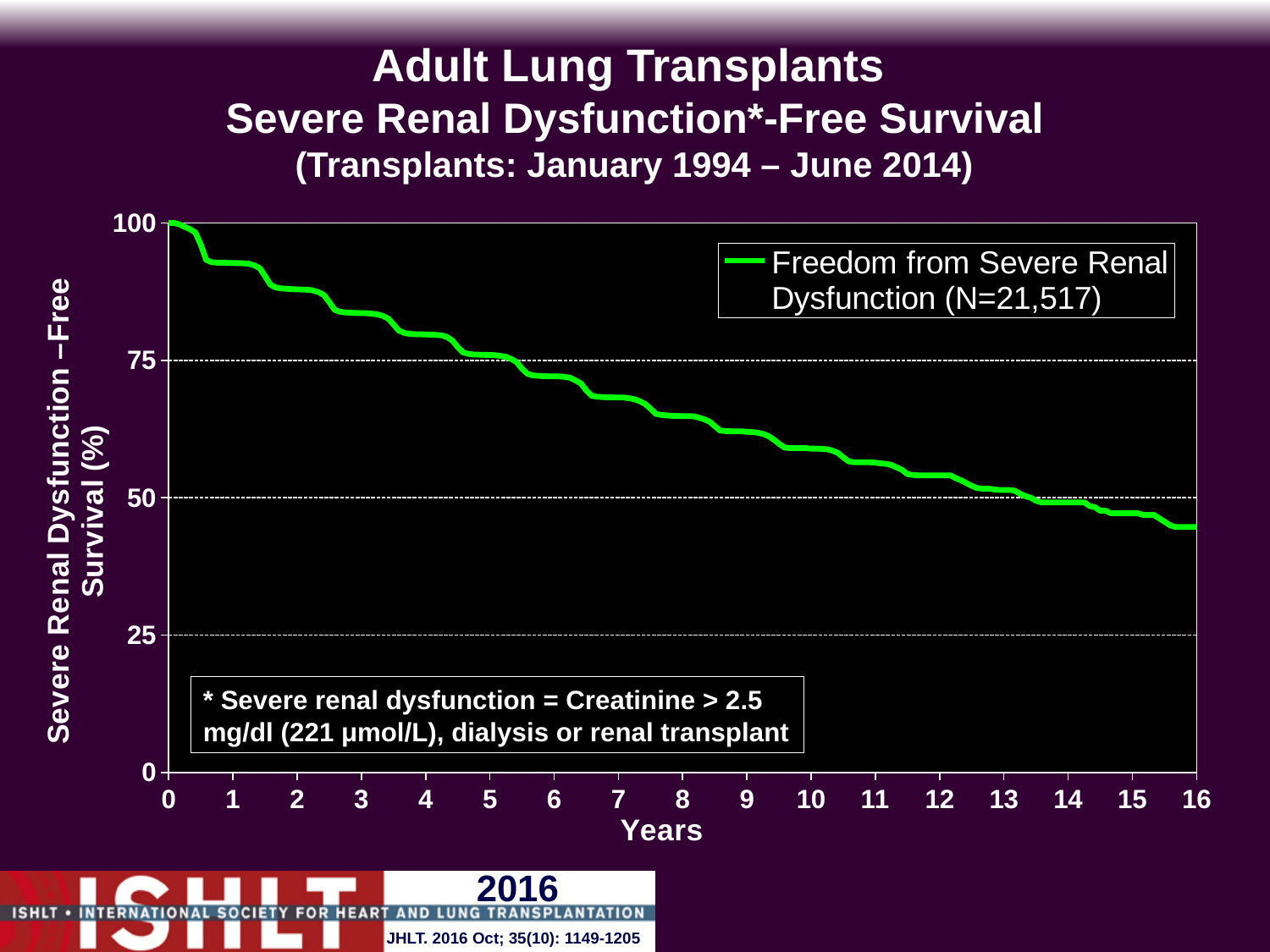
Which has the higher survival value, year 3 or year 12? year 3 Does the survival curve rise or fall as the years increase? fall Is the survival value at year 6 greater or less than 75? less Is the survival value at year 4 greater or less than 75? greater How many series does the legend list? 1 What is the severe renal dysfunction-free survival (%) at year 0? 100 What kind of chart is shown on the slide? line chart What is the main title of the chart? Adult Lung Transplants Severe Renal Dysfunction*-Free Survival Is the survival value at year 10 greater or less than 50? greater What is the N value given in the legend for Freedom from Severe Renal Dysfunction? N=21,517 At which year on the x axis is the survival curve at its highest? 0